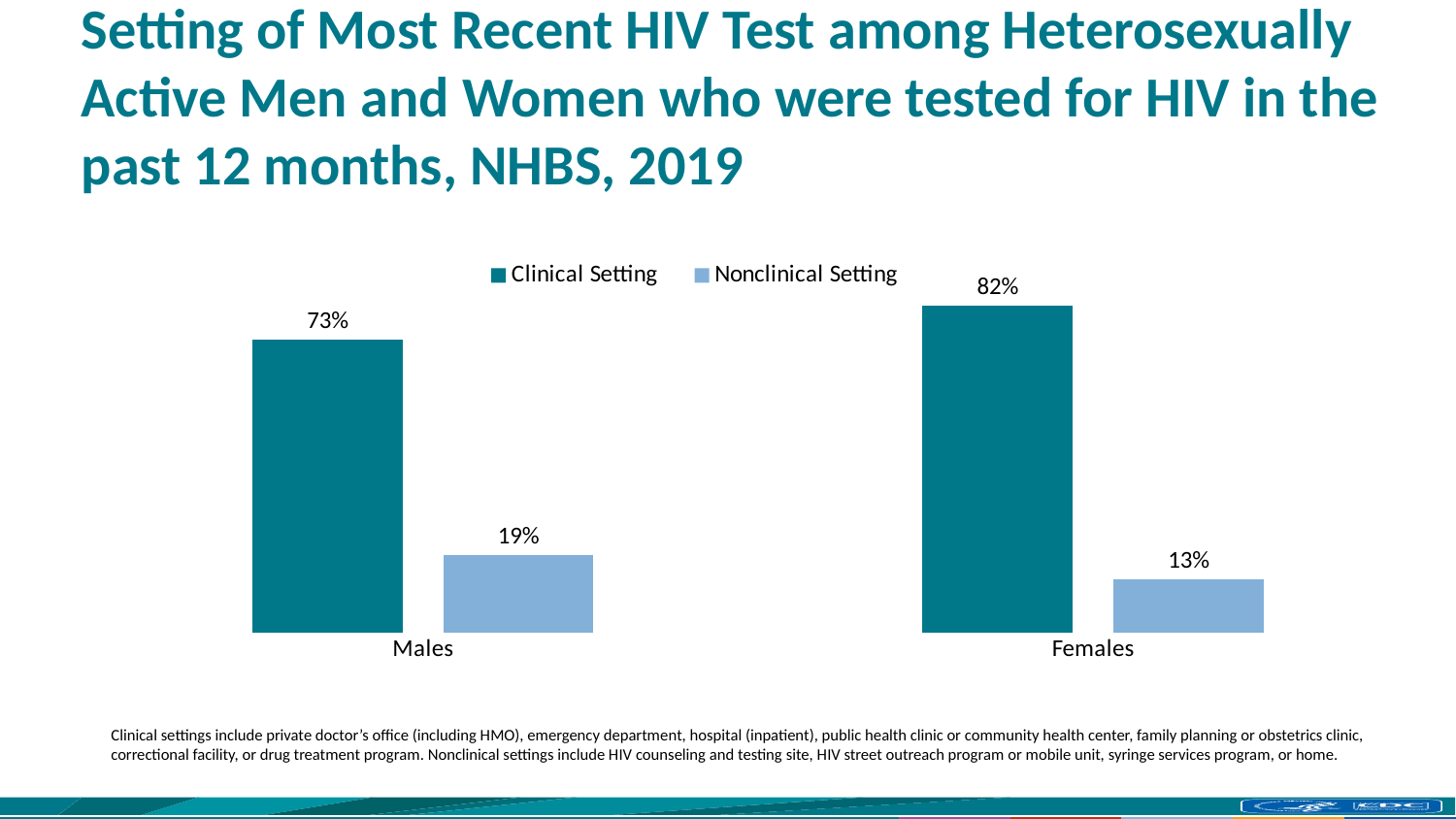
What percentage of males had their most recent HIV test in a clinical setting? 73% What is the value for Nonclinical Setting among males? 19% Which group has the lower percentage tested in a nonclinical setting? Females What is the difference between the clinical and nonclinical setting percentages for males? 54% How many categories are shown on the x axis? 2 What is the difference between the clinical setting percentages for females and males? 9% What type of chart is shown on the slide? Bar chart How many series does the legend list? 2 Which series is shown in the darker teal colour? Clinical Setting Which group has the higher percentage tested in a clinical setting, males or females? Females What is the value for Clinical Setting among females? 82% What percentage of females had their most recent HIV test in a nonclinical setting? 13%